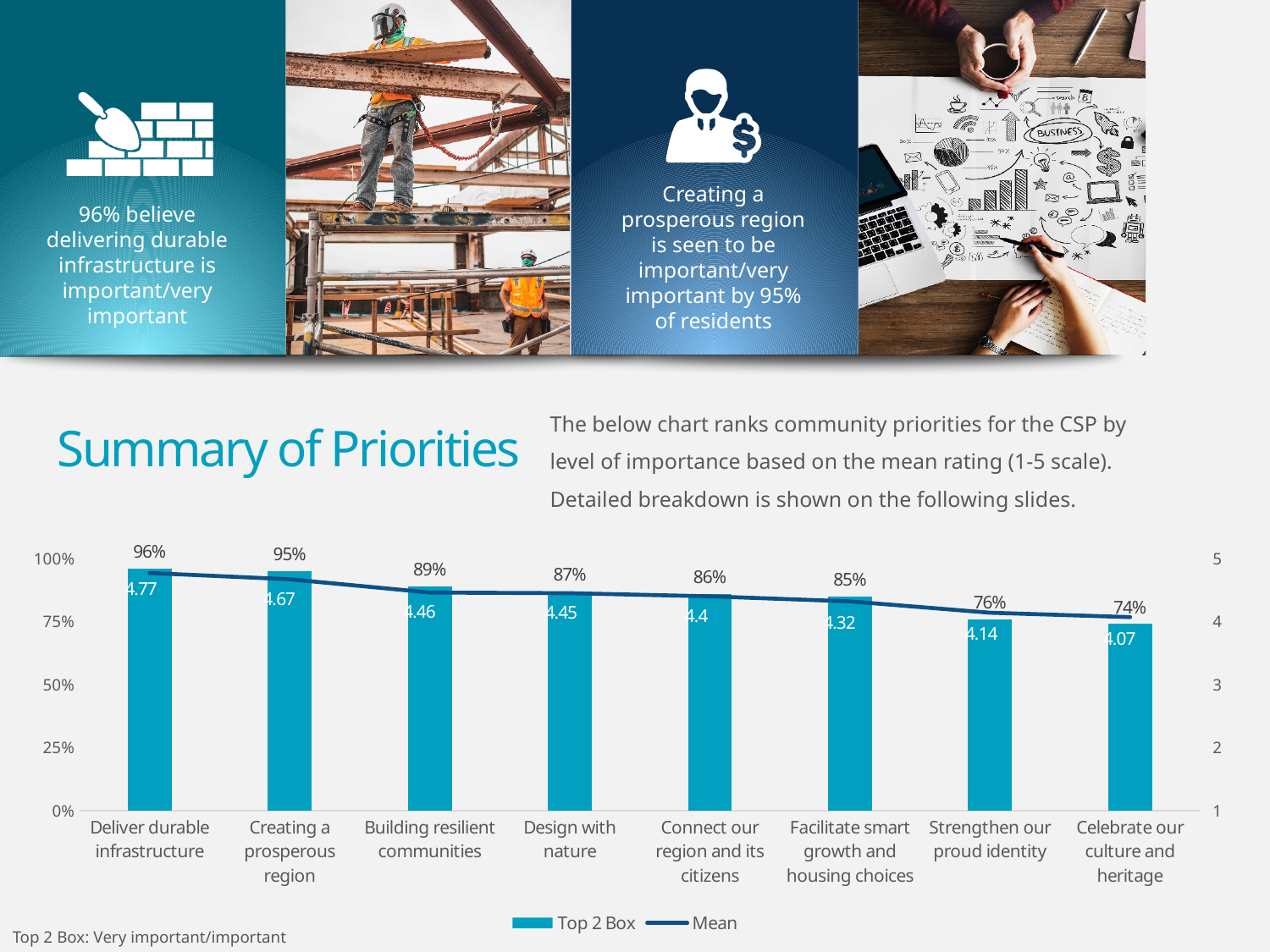
Which category has the highest Top 2 Box value? Deliver durable infrastructure What is the Mean rating for Facilitate smart growth and housing choices? 4.32 Which category has the lowest Mean rating? Celebrate our culture and heritage How many categories are shown on the x axis of the chart? 8 What is the Mean rating for Celebrate our culture and heritage? 4.07 What is the difference in Top 2 Box value between Deliver durable infrastructure and Celebrate our culture and heritage? 22% Is the Top 2 Box value for Strengthen our proud identity greater or less than 75%? greater Do the Top 2 Box values rise or fall from left to right along the x axis? fall Which has a higher Top 2 Box value, Design with nature or Strengthen our proud identity? Design with nature What is the Top 2 Box value for Deliver durable infrastructure? 96% What are the two series named in the chart legend? Top 2 Box and Mean How many series does the chart legend list? 2